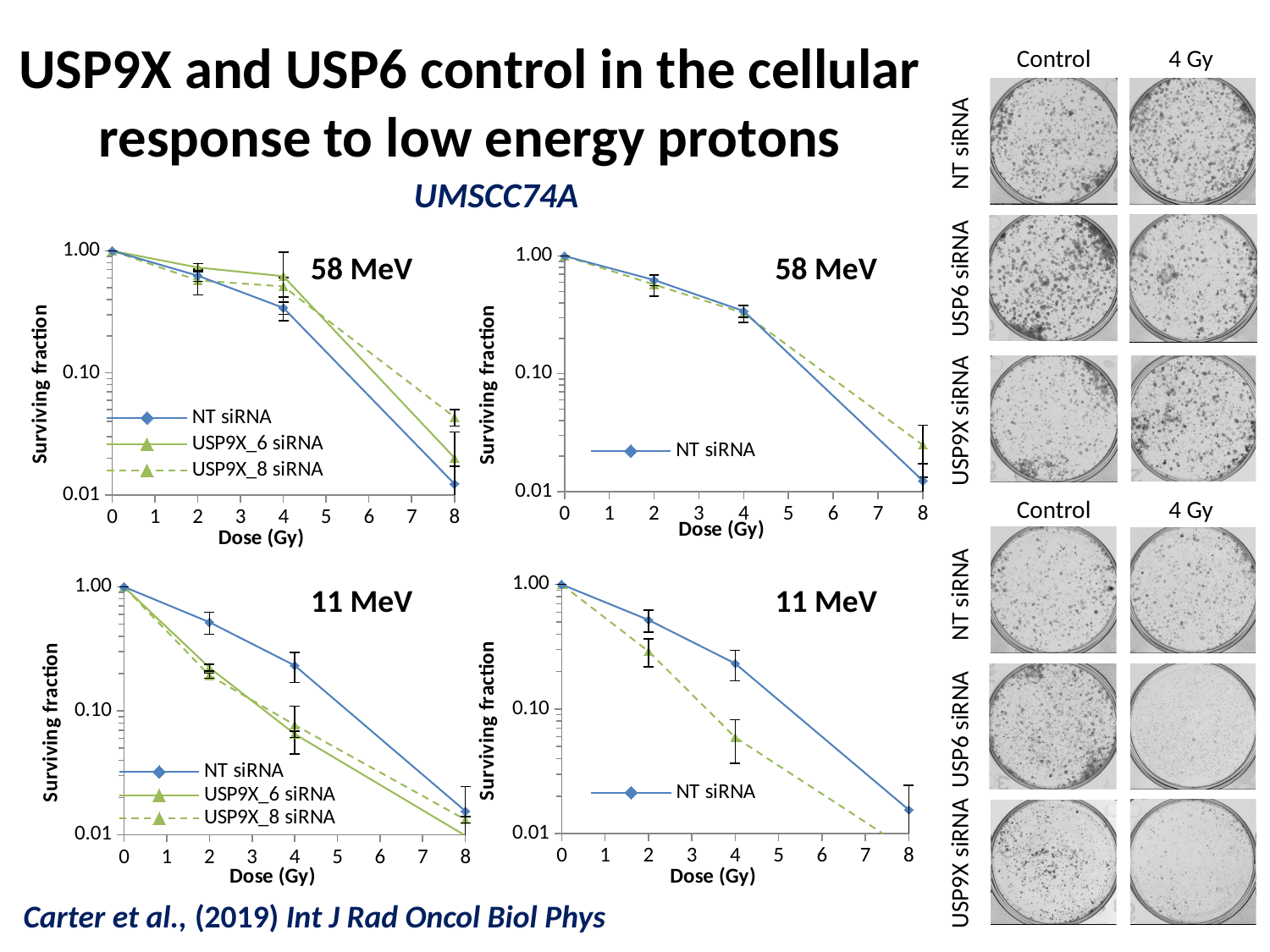
How many series does the legend of the top-right 58 MeV chart list? 1 How many series does the legend of the top-left 58 MeV chart list? 3 In the bottom-left 11 MeV chart, is the USP9X_6 siRNA surviving fraction at 4 Gy greater or less than 0.10? less In the top-left 58 MeV chart, is the NT siRNA surviving fraction at 2 Gy greater or less than 0.10? greater In the top-left 58 MeV chart, is the NT siRNA surviving fraction at 8 Gy greater or less than 0.10? less In the bottom-left 11 MeV chart, does the NT siRNA surviving fraction rise or fall as dose increases? fall What is the y-axis label of the bottom-right 11 MeV chart? Surviving fraction How many dose points are plotted for the NT siRNA series in the top-left 58 MeV chart? 4 What type of chart is the top-left 58 MeV chart? line chart In the bottom-left 11 MeV chart, which series has the higher surviving fraction at 2 Gy, NT siRNA or USP9X_6 siRNA? NT siRNA What is the x-axis label of the top-right 58 MeV chart? Dose (Gy)